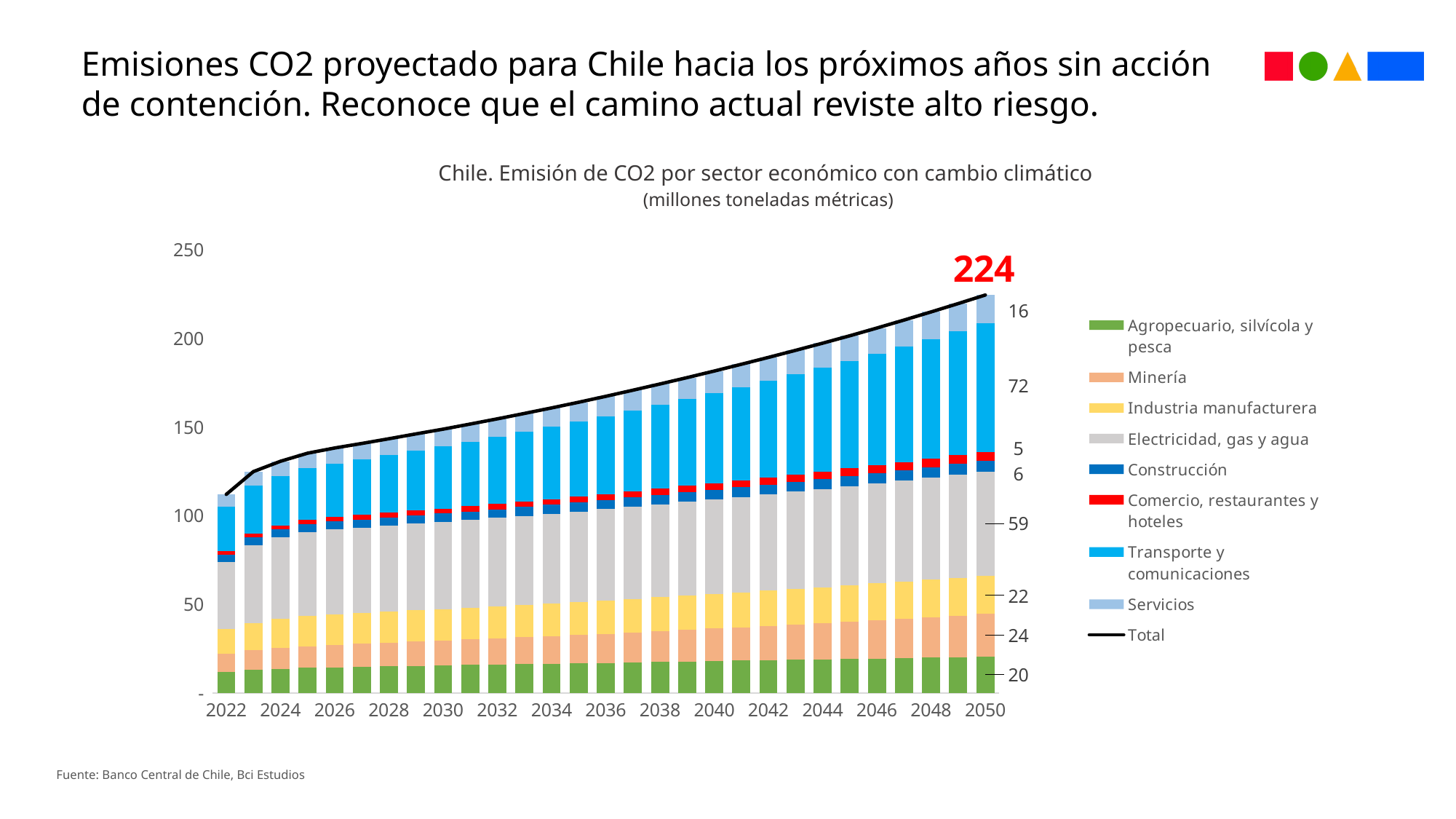
Which sector has the highest value in 2050? Transporte y comunicaciones What is the value for Electricidad, gas y agua in 2050? 59 Which sector has the lowest value in 2050? Comercio, restaurantes y hoteles What is the difference between Transporte y comunicaciones and Electricidad, gas y agua in 2050? 13 What is the total CO2 emission value shown for 2050? 224 What is the value for Minería in 2050? 24 How many series does the legend list? 9 What is the value for Transporte y comunicaciones in 2050? 72 Is the total for 2022 greater or less than 150? less What is the value for Agropecuario, silvícola y pesca in 2050? 20 Does the total line rise or fall from 2022 to 2050? Rise What kind of chart is shown on the slide? Stacked bar chart with a line